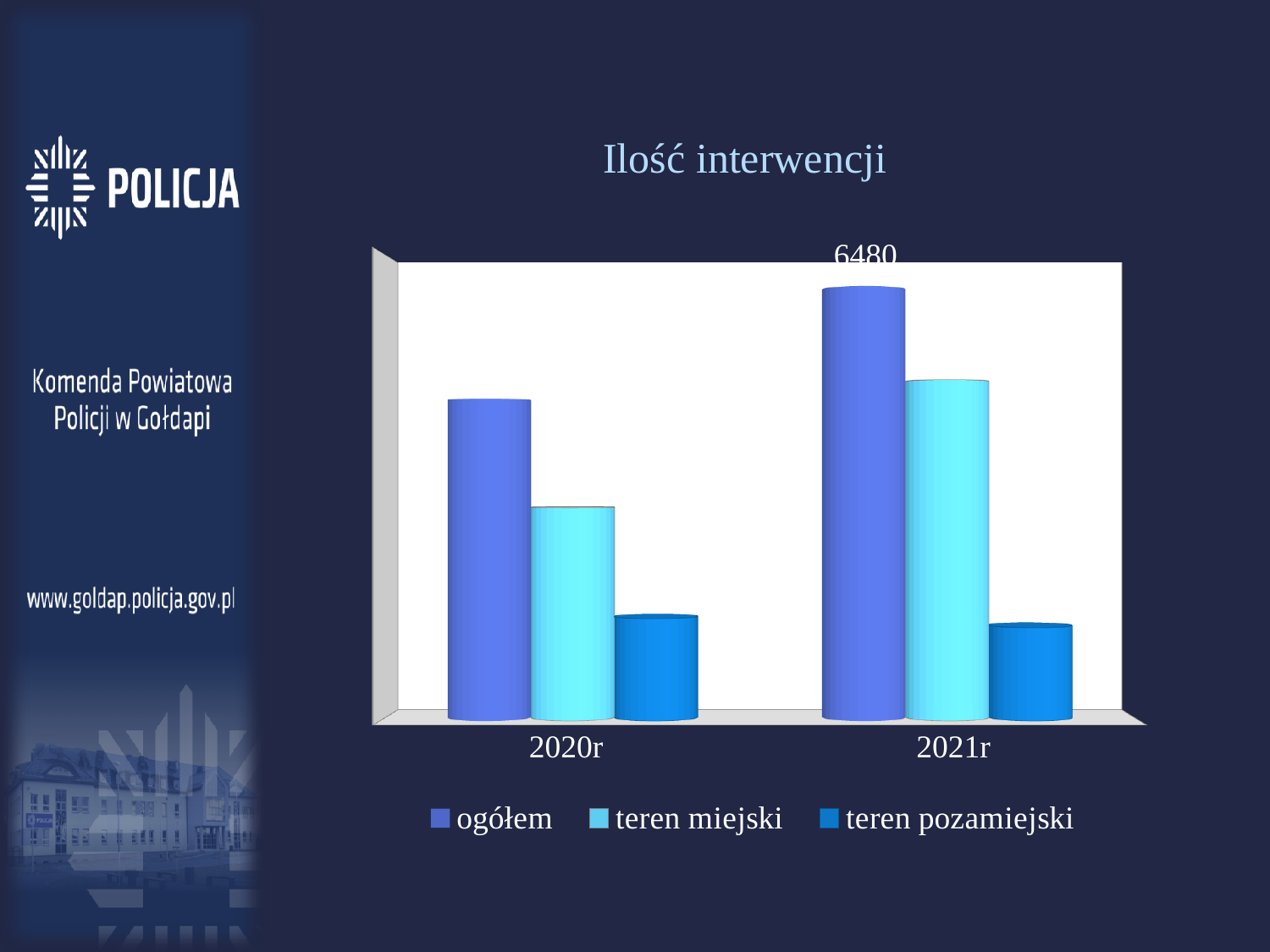
Does the ogółem value rise or fall from 2020r to 2021r? rise What kind of chart is shown on the slide? bar chart How many series does the legend list? 3 Which series is shown in the darkest blue colour in the legend? teren pozamiejski Which series has the highest bar in 2021r? ogółem Which series has the lowest bar in 2020r? teren pozamiejski How many categories are shown on the x axis? 2 Which is larger, teren miejski or teren pozamiejski in 2021r? teren miejski Which is larger, the ogółem value for 2020r or for 2021r? 2021r Does the teren miejski value rise or fall from 2020r to 2021r? rise What is the value for ogółem in 2021r? 6480 What is the title of the chart? Ilość interwencji